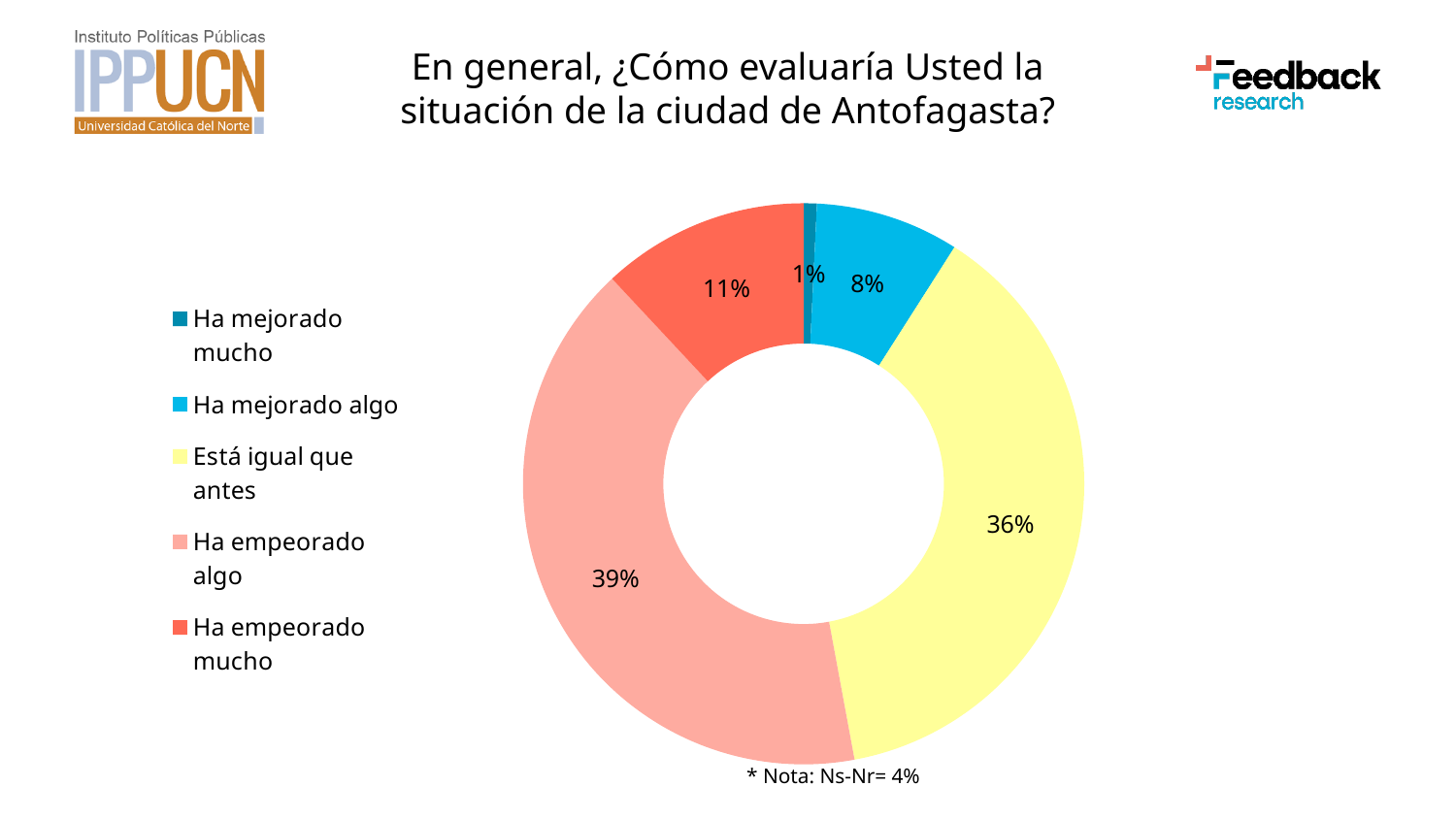
What percentage of respondents answered "Ha mejorado mucho"? 1% Which response category has the largest share of the chart? Ha empeorado algo What percentage of respondents answered "Está igual que antes"? 36% What percentage of respondents answered "Ha empeorado algo"? 39% According to the note below the chart, what is the Ns-Nr percentage? 4% How many response categories does the legend list? 5 What percentage of respondents answered "Ha mejorado algo"? 8% Which is larger, the share for "Ha empeorado mucho" or the share for "Ha mejorado algo"? Ha empeorado mucho Which response category has the smallest share of the chart? Ha mejorado mucho What kind of chart is shown on the slide? Pie chart (donut) What percentage of respondents answered "Ha empeorado mucho"? 11% What is the difference in percentage points between "Ha empeorado algo" and "Está igual que antes"? 3